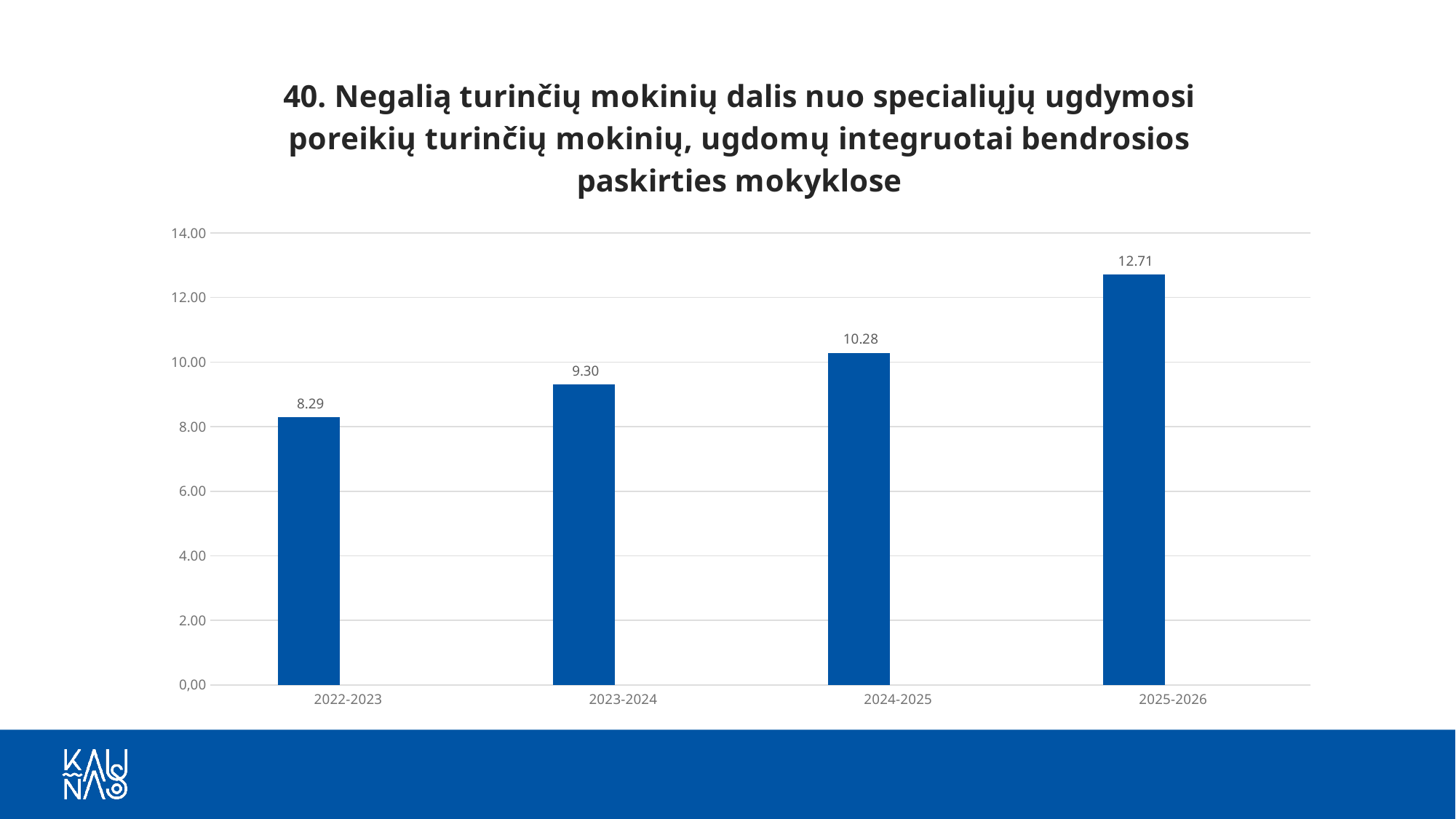
What is the value for 2023-2024? 9.30 What is the value for 2025-2026? 12.71 Which school year has the highest value? 2025-2026 Which school year has the lowest value? 2022-2023 What kind of chart is shown on the slide? bar chart How many school years are shown on the chart? 4 What is the difference between the values for 2025-2026 and 2022-2023? 4.42 Which is larger, the value for 2023-2024 or the value for 2024-2025? 2024-2025 Is the value for 2025-2026 greater or less than 12.00? greater Do the values rise or fall from 2022-2023 to 2025-2026? rise What is the value for 2022-2023? 8.29 What is the value for 2024-2025? 10.28